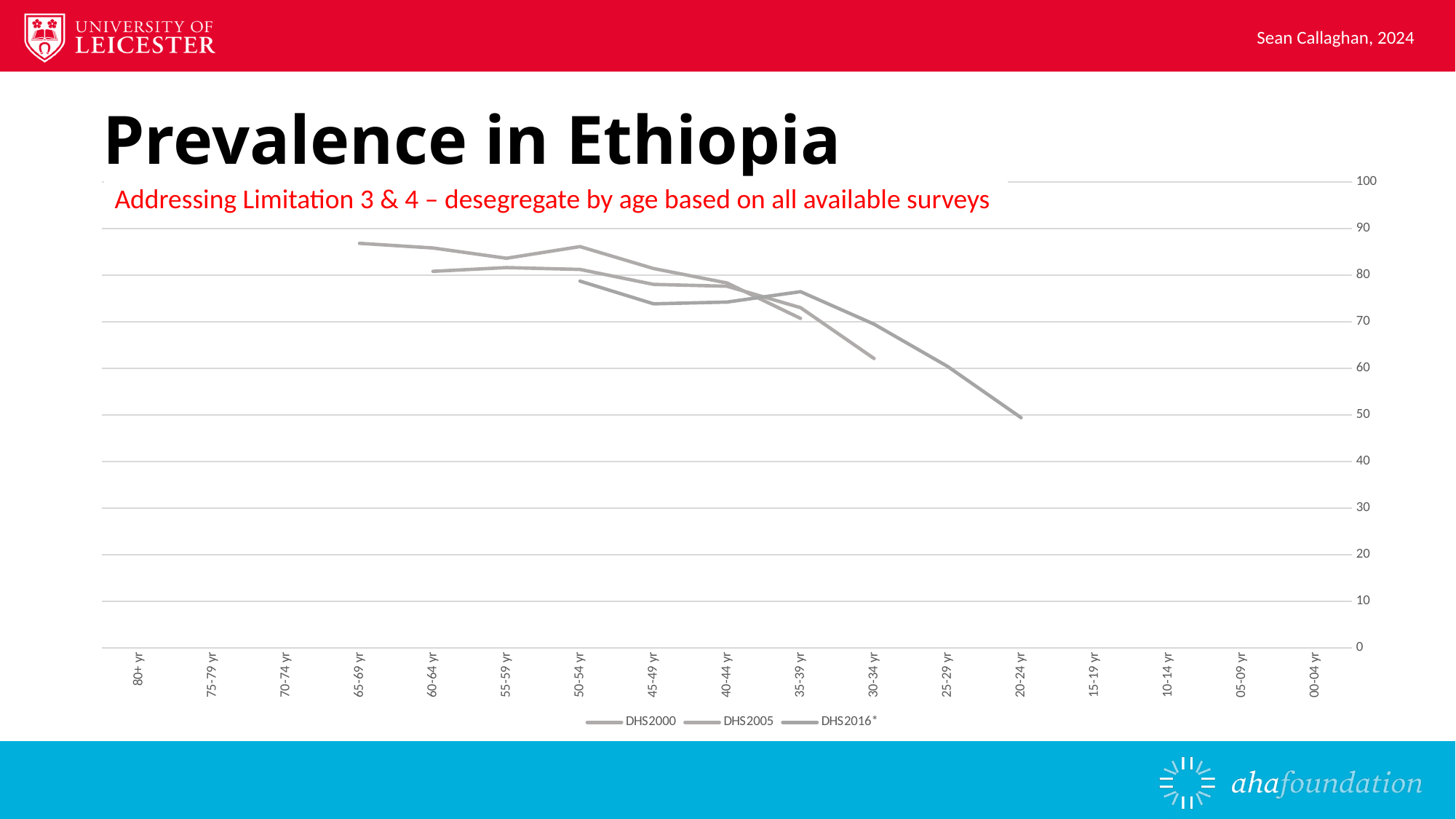
Is the plotted value for the 65-69 yr age group greater or less than 80? greater Are all the plotted values for the 40-44 yr age group greater or less than 80? less Do the plotted values generally rise or fall moving from the older age groups on the left to the younger age groups on the right? fall Is the plotted value for the 20-24 yr age group greater or less than 60? less How many series does the legend list? 3 What is the title of the slide containing the chart? Prevalence in Ethiopia What kind of chart is shown on the slide? line chart Which age group has the lowest plotted value on the chart? 20-24 yr How many age-group categories are shown on the x axis? 17 What are the three series named in the legend? DHS2000, DHS2005, DHS2016*